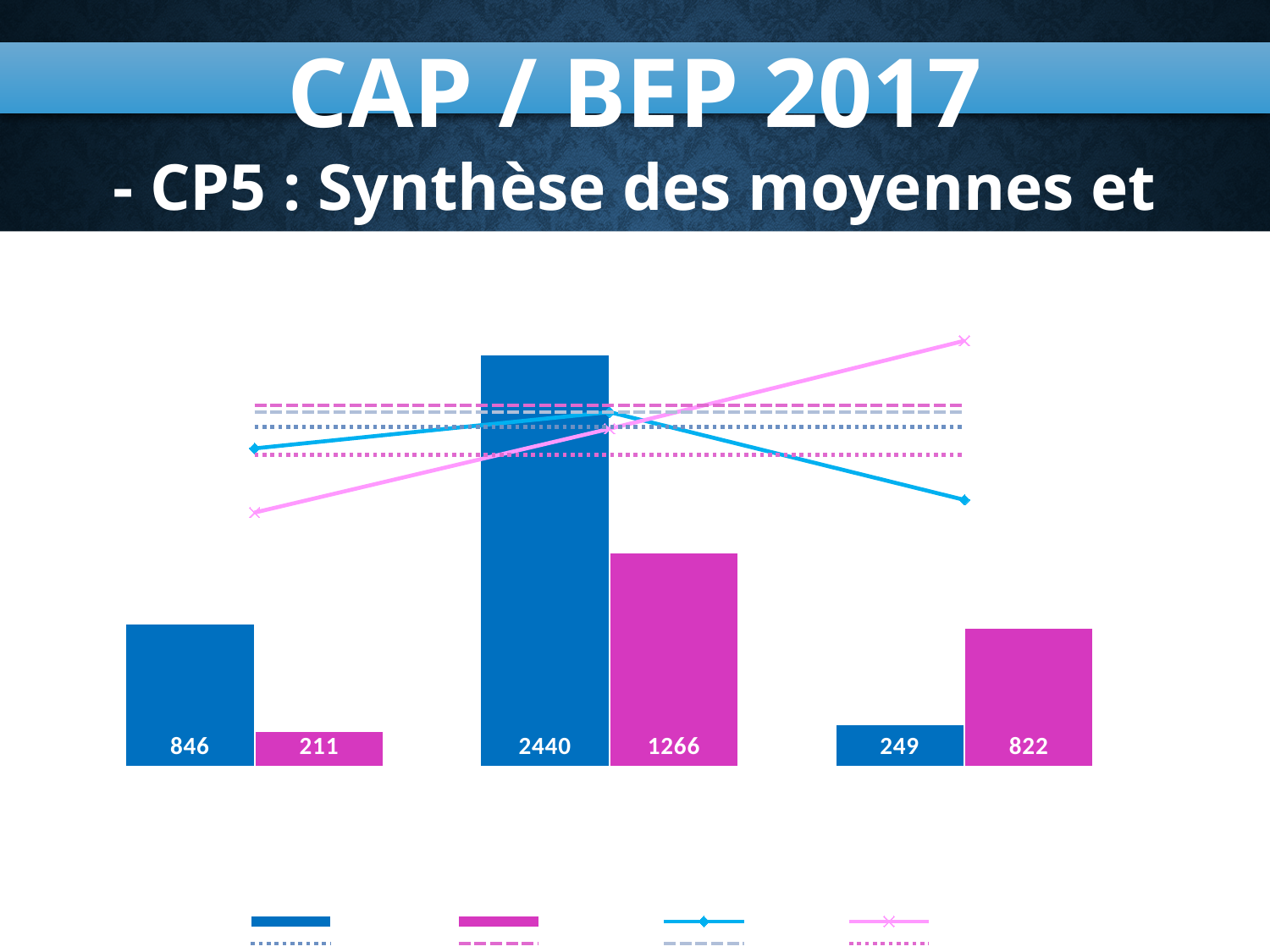
In the rightmost group, which bar is larger, the blue one or the magenta one? The magenta one (822) What is the value printed on the blue bar in the rightmost group? 249 What is the value printed on the leftmost blue bar? 846 What kind of chart is shown on the slide? A bar chart combined with line series Which bar has the lowest printed value? The magenta bar in the left group (211) Which bar has the highest printed value? The blue bar in the middle group (2440) What is the value printed on the magenta bar in the middle group? 1266 How many bars are plotted on the chart? 6 What is the value printed on the blue bar in the middle group? 2440 What is the value printed on the rightmost magenta bar? 822 What is the difference between the blue and magenta bars in the middle group? 1174 What is the value printed on the magenta bar in the left group? 211